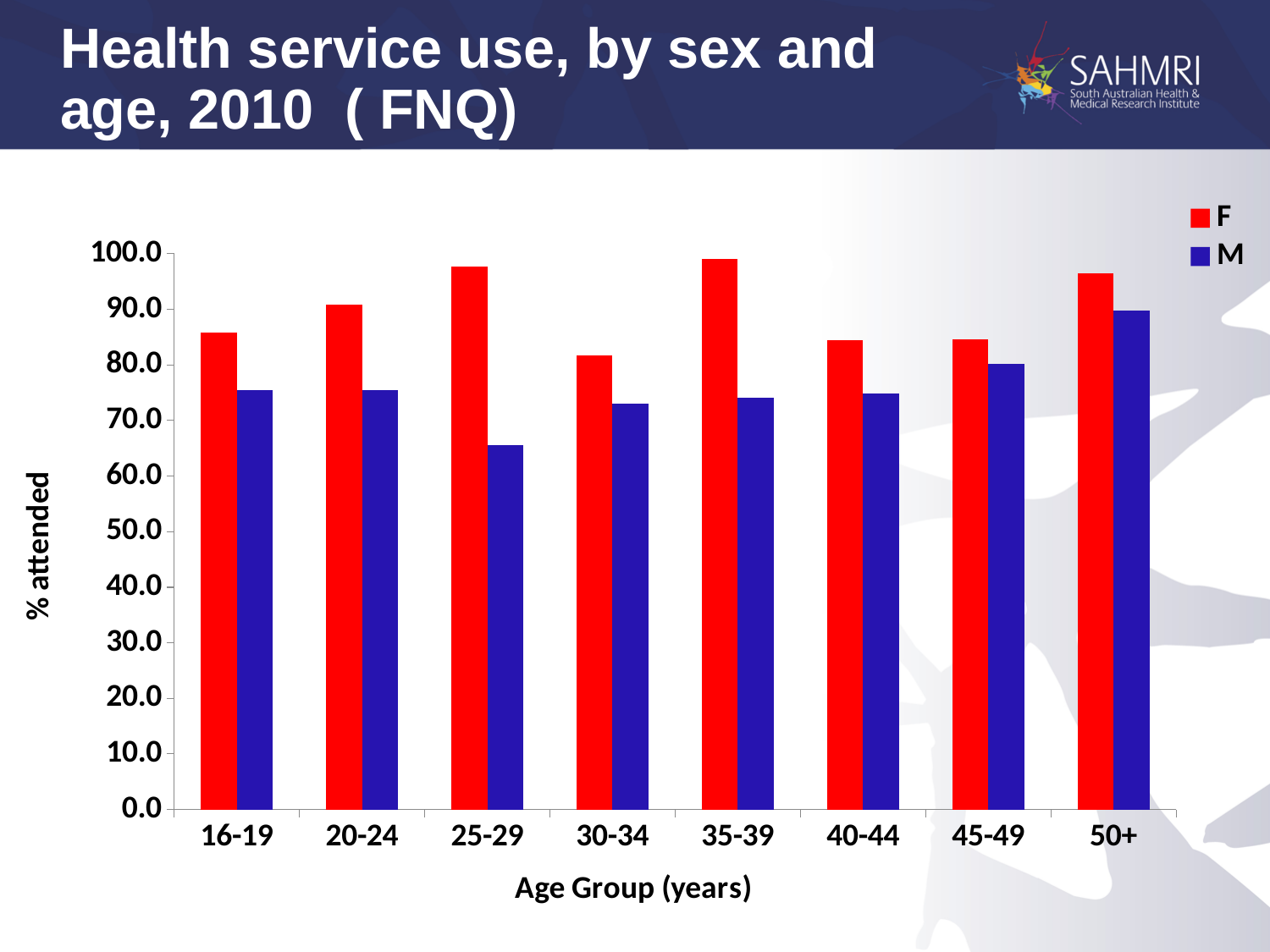
What is the label of the y axis? % attended Is the value for M in the 50+ age group greater or less than 80.0? greater How many series does the legend list? 2 In the 35-39 age group, which is larger, F or M? F Which age group has the lowest value for F? 30-34 What kind of chart is shown on the slide? bar chart How many age groups are shown on the x axis? 8 Is the value for F in the 25-29 age group greater or less than 90.0? greater Which age group has the lowest value for M? 25-29 Is the value for F in the 16-19 age group greater or less than 90.0? less Which age group has the highest value for M? 50+